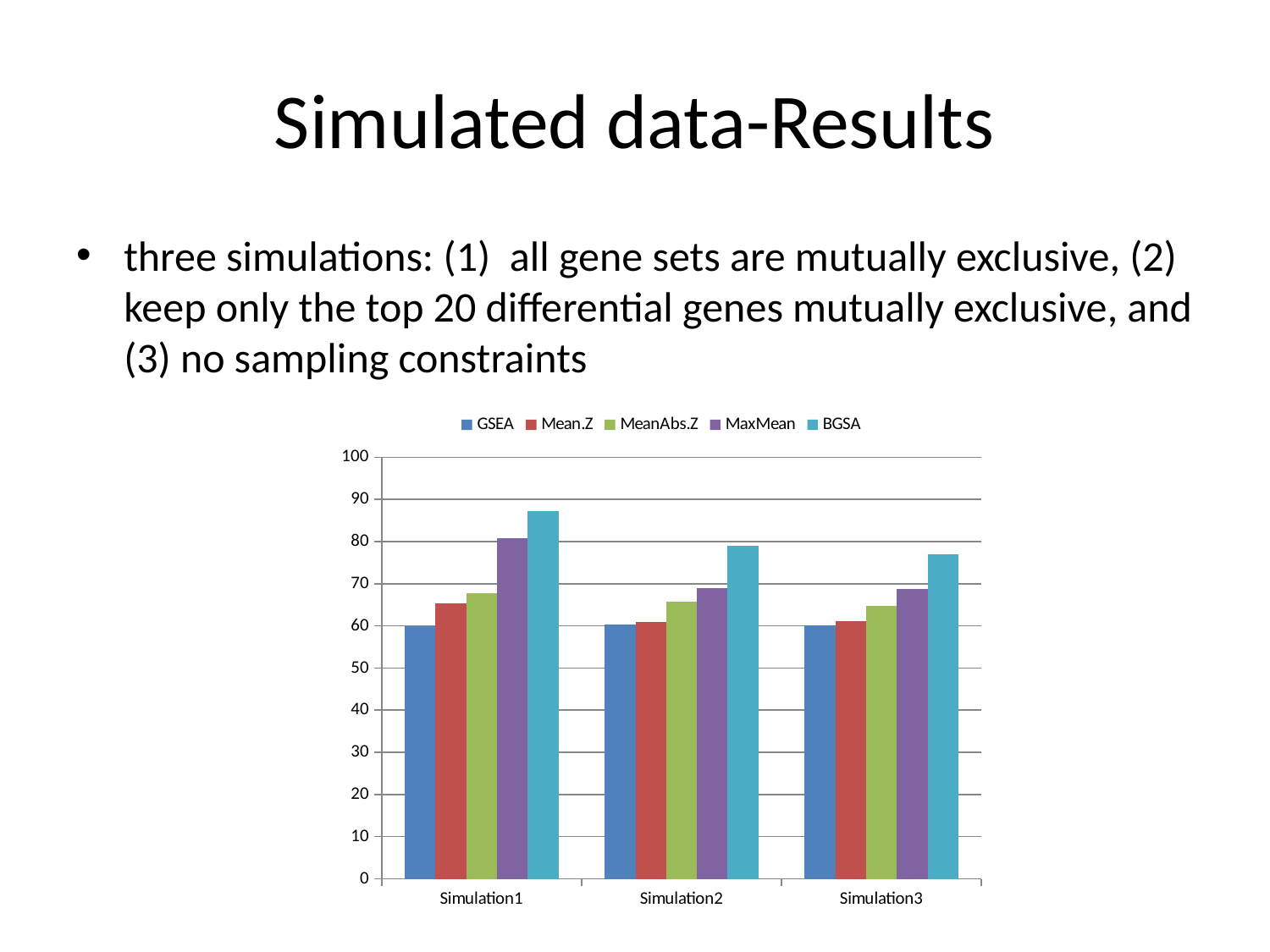
Which series has the highest value in Simulation1? BGSA Is the BGSA value for Simulation1 greater or less than 80? greater Is the MeanAbs.Z value for Simulation3 greater or less than 60? greater How many series does the legend list? 5 Which is larger in Simulation3, MaxMean or Mean.Z? MaxMean What kind of chart is shown on the slide? bar chart Is the Mean.Z value for Simulation1 greater or less than 70? less Which series has the lowest value in Simulation1? GSEA Which series is listed first in the legend? GSEA Which is larger, the BGSA value for Simulation1 or for Simulation2? Simulation1 Do the BGSA values rise or fall from Simulation1 to Simulation3? fall How many simulation categories are shown on the x axis? 3